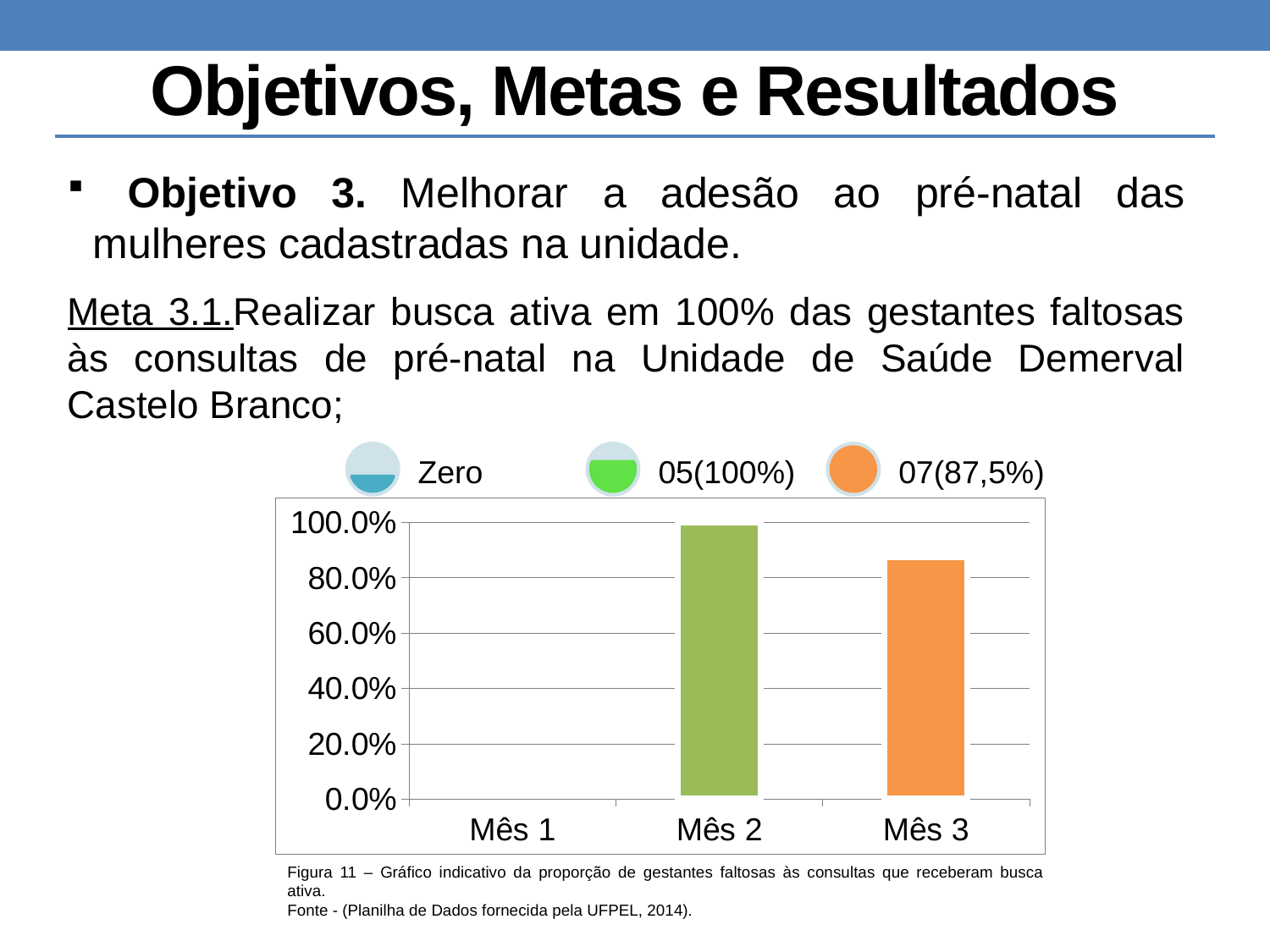
What colour is the bar for Mês 3? orange How many categories are shown on the x axis of the chart? 3 How many entries does the chart legend list? 3 Which month has the highest value in the chart? Mês 2 What is the value for Mês 2 in the chart? 100% Is the value for Mês 3 greater or less than 80.0%? greater What is the value for Mês 3 according to the chart legend? 87,5% Does the value fall or rise from Mês 2 to Mês 3? fall Which month has the lowest value in the chart? Mês 1 What type of chart is shown on the slide? bar chart Which is larger, the value for Mês 2 or the value for Mês 3? Mês 2 What legend label is given for Mês 1 in the chart? Zero